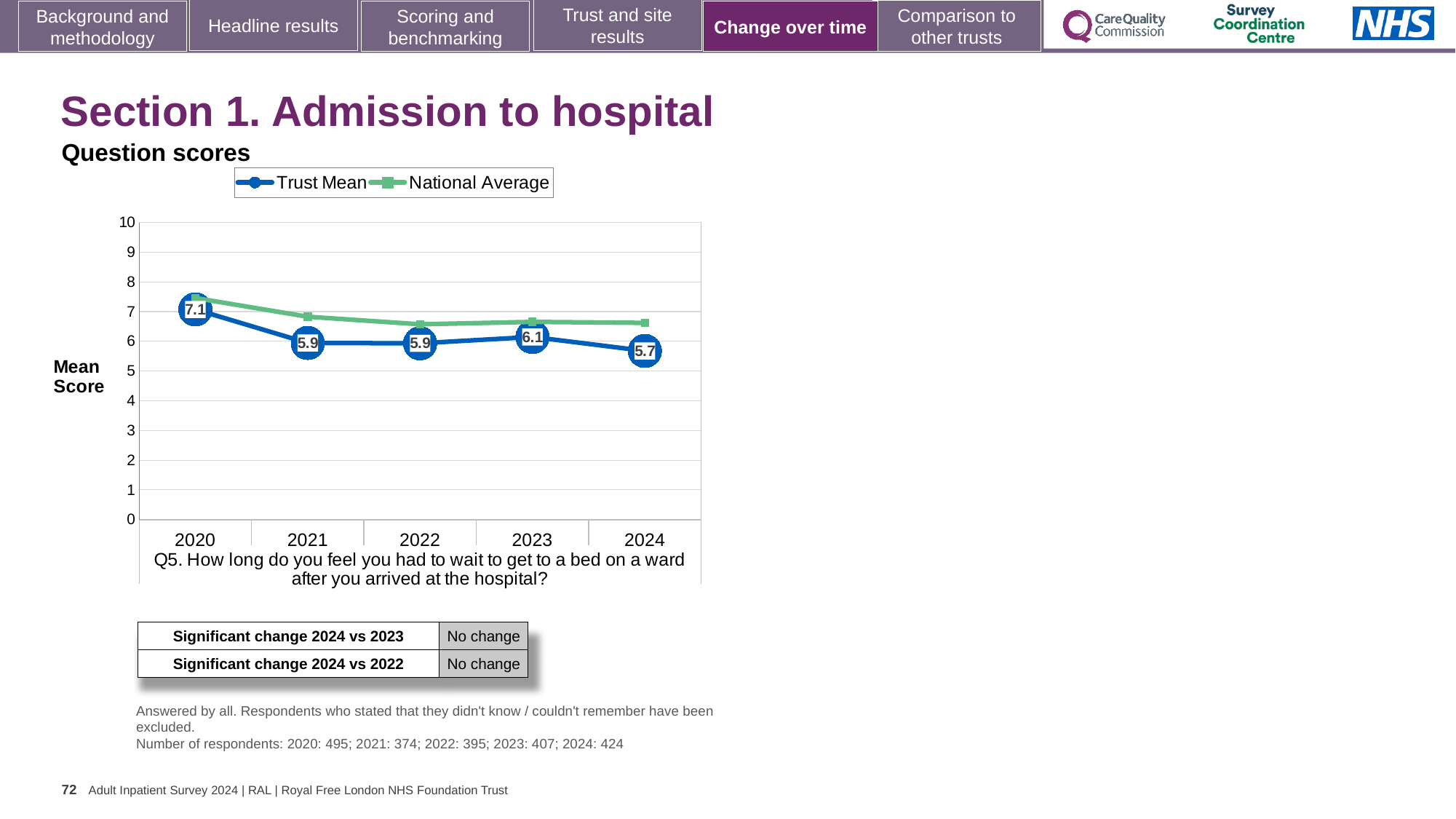
How many years are shown on the x axis? 5 In which year is the Trust Mean highest? 2020 Is the National Average for 2022 greater or less than 7? less How many series does the legend list? 2 What is the Trust Mean score for 2024? 5.7 What is the Trust Mean score for 2023? 6.1 What is the difference between the Trust Mean in 2020 and in 2024? 1.4 What kind of chart is shown on the slide? Line chart In which year is the Trust Mean lowest? 2024 What is the Trust Mean score for 2020? 7.1 Which is larger, the Trust Mean in 2023 or in 2024? 2023 Is the National Average for 2020 greater or less than 7? greater